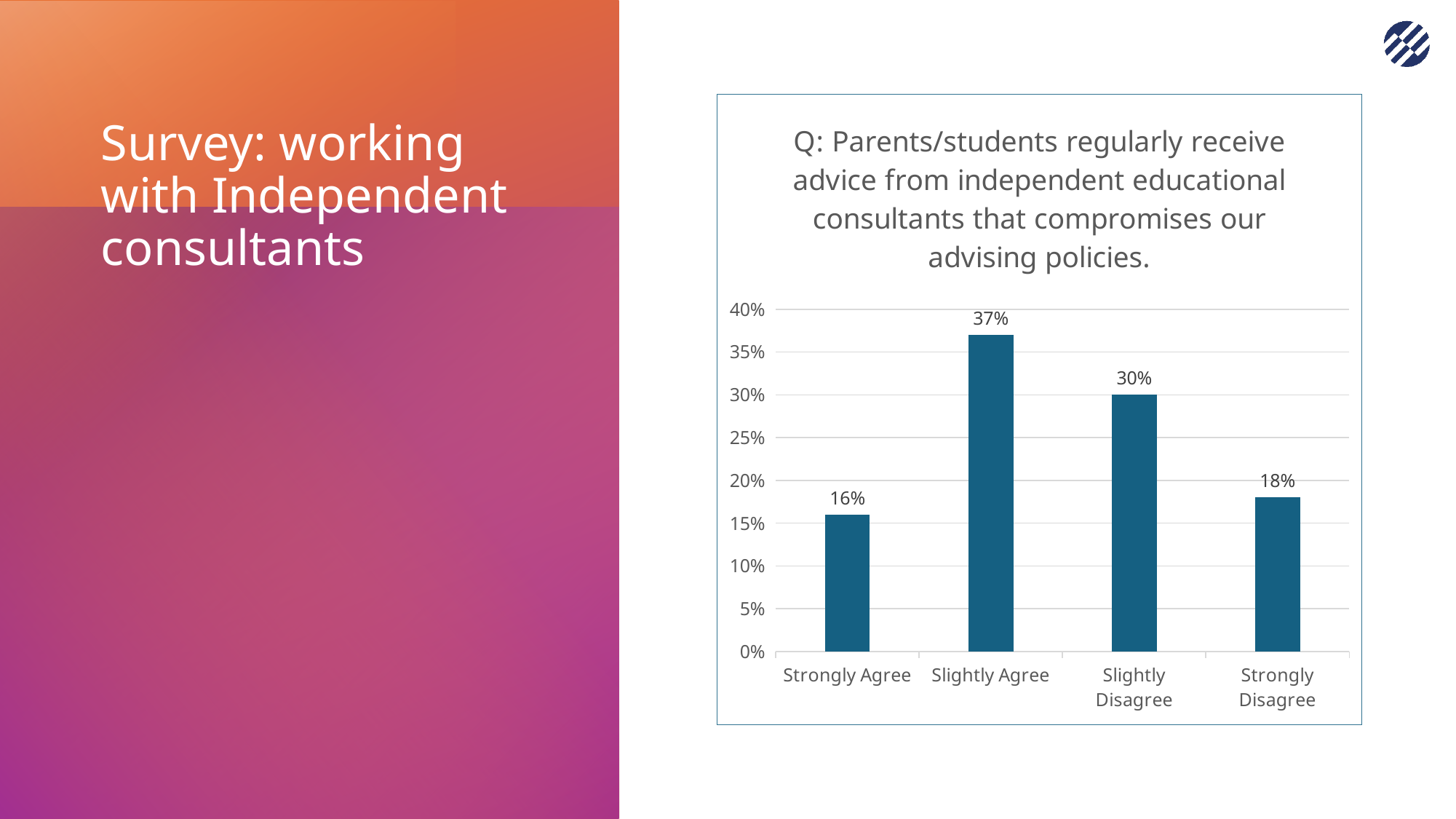
What percentage of respondents answered Slightly Disagree? 30% Is the value for Slightly Disagree greater or less than 25%? greater What percentage of respondents answered Strongly Agree? 16% How many response categories are shown on the chart? 4 Which is larger, the percentage for Strongly Disagree or for Strongly Agree? Strongly Disagree Which response category has the highest percentage? Slightly Agree What percentage of respondents answered Slightly Agree? 37% What is the difference in percentage points between Slightly Agree and Slightly Disagree? 7 percentage points What percentage of respondents answered Strongly Disagree? 18% Which response category has the lowest percentage? Strongly Agree What is the maximum value shown on the vertical axis of the chart? 40% What kind of chart is shown on the slide? Bar chart